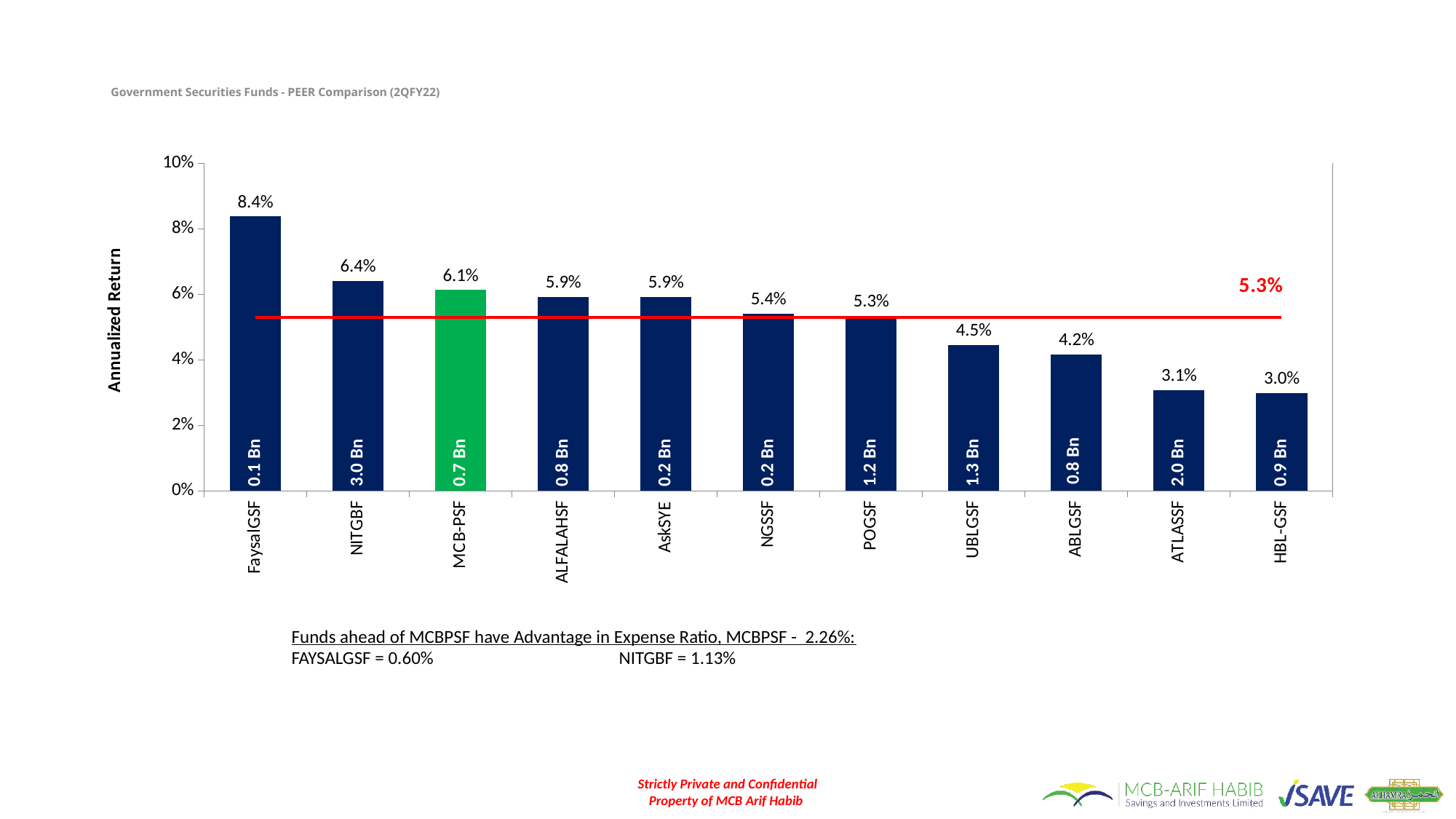
Do the annualized returns rise or fall from left to right across the funds? fall Which has a higher annualized return, UBLGSF or ABLGSF? UBLGSF Which fund has the lowest annualized return? HBL-GSF What is the difference in annualized return between FaysalGSF and NITGBF? 2.0% What value is labelled on the red horizontal line? 5.3% What is the annualized return for MCB-PSF? 6.1% Which fund has the highest annualized return? FaysalGSF What type of chart is shown on the slide? bar chart What fund size is printed inside the NITGBF bar? 3.0 Bn What is the annualized return for FaysalGSF? 8.4% Is the annualized return for ATLASSF greater or less than 4%? less How many funds are shown on the chart? 11